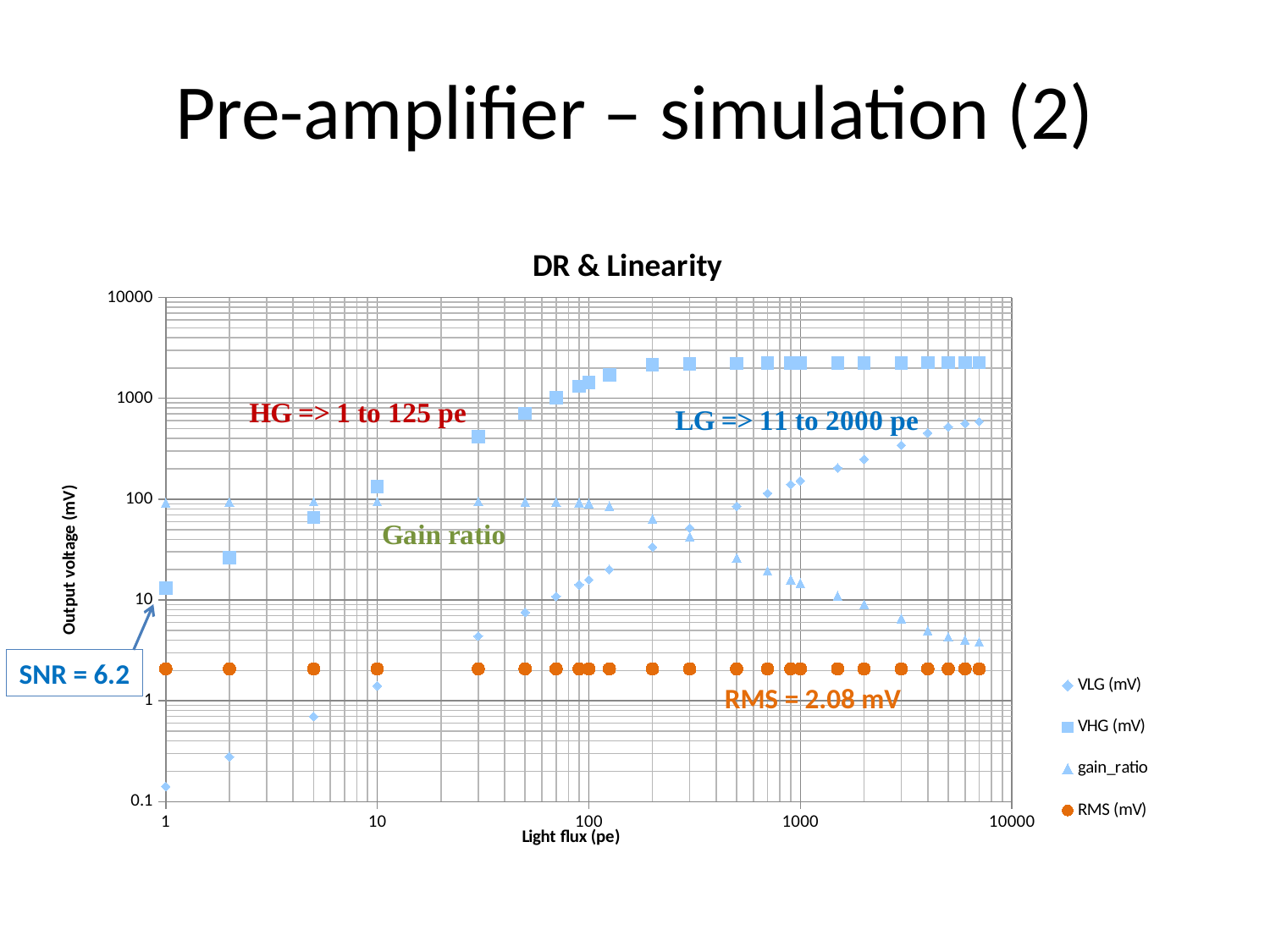
How many series does the chart legend list? 4 What is the label of the y axis? Output voltage (mV) What kind of chart is shown on the slide? scatter chart What RMS value is annotated on the chart? 2.08 mV What is the title of the chart? DR & Linearity Is the RMS (mV) value at a light flux of 100 greater or less than 10? less Is the VHG (mV) value at a light flux of 1 greater or less than 10? greater Is the VLG (mV) value at a light flux of 1 greater or less than 1? less At a light flux of 1000, which is larger: VHG (mV) or VLG (mV)? VHG (mV) Do the VLG (mV) values rise or fall as light flux increases? rise